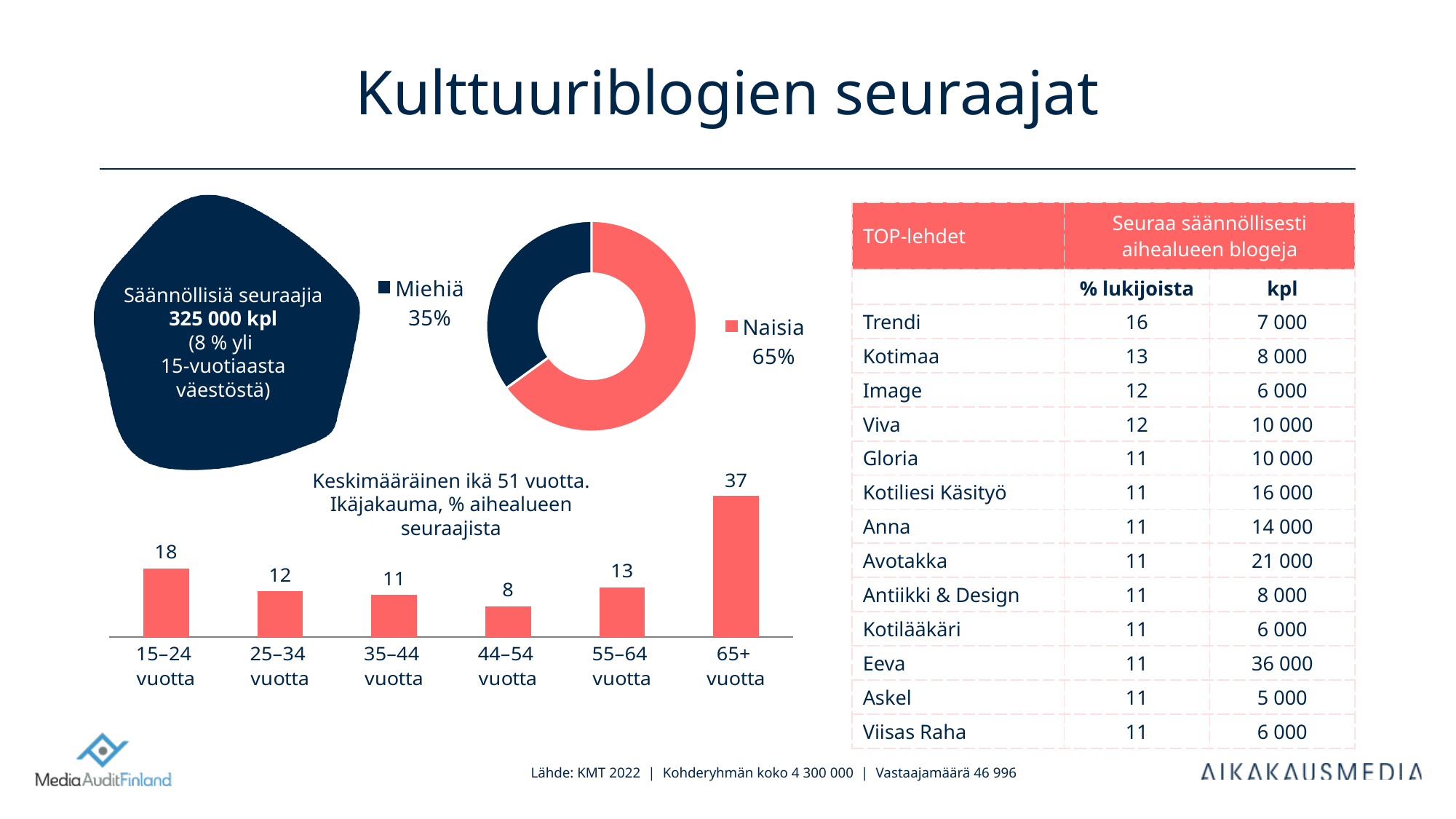
In the age distribution bar chart, which age group has the highest value? 65+ vuotta In the age distribution bar chart, which age group has the lowest value? 44–54 vuotta In the age distribution bar chart, which is larger, the value for 25–34 vuotta or 55–64 vuotta? 55–64 vuotta What type of chart shows the age distribution (Ikäjakauma)? Bar chart In the age distribution bar chart, what is the value for 65+ vuotta? 37 In the age distribution bar chart, what is the difference between the values for 65+ vuotta and 15–24 vuotta? 19 In the donut chart, which group has the larger share, Miehiä or Naisia? Naisia How many age groups are shown in the age distribution bar chart? 6 How many slices does the donut chart have? 2 In the age distribution bar chart, what is the value for 15–24 vuotta? 18 In the donut chart, what share is Miehiä? 35% In the donut chart, what share is Naisia? 65%